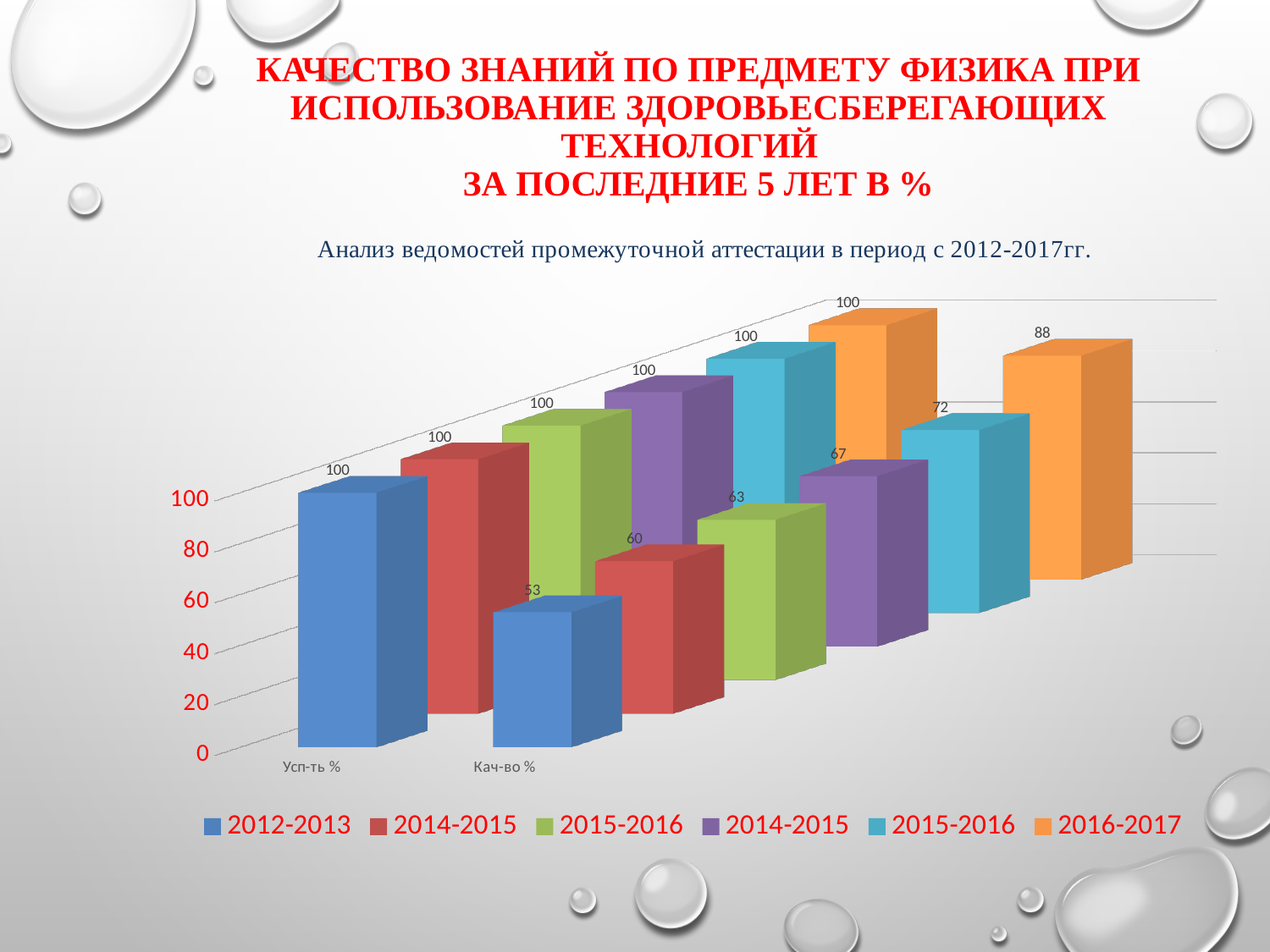
What is the value of the light blue bar in the Кач-во % category? 72 Which series has the lowest value in the Кач-во % category? 2012-2013 How many categories are shown on the x axis? 2 What is the value for 2016-2017 in the Усп-ть % category? 100 What is the value of the red bar in the Кач-во % category? 60 Which series has the highest value in the Кач-во % category? 2016-2017 For the 2012-2013 series, which category has the larger value, Усп-ть % or Кач-во %? Усп-ть % What is the value for 2012-2013 in the Кач-во % category? 53 How many series does the legend list? 6 What is the value for 2016-2017 in the Кач-во % category? 88 What kind of chart is shown on the slide? bar chart What is the difference between the 2016-2017 and 2012-2013 values in the Кач-во % category? 35